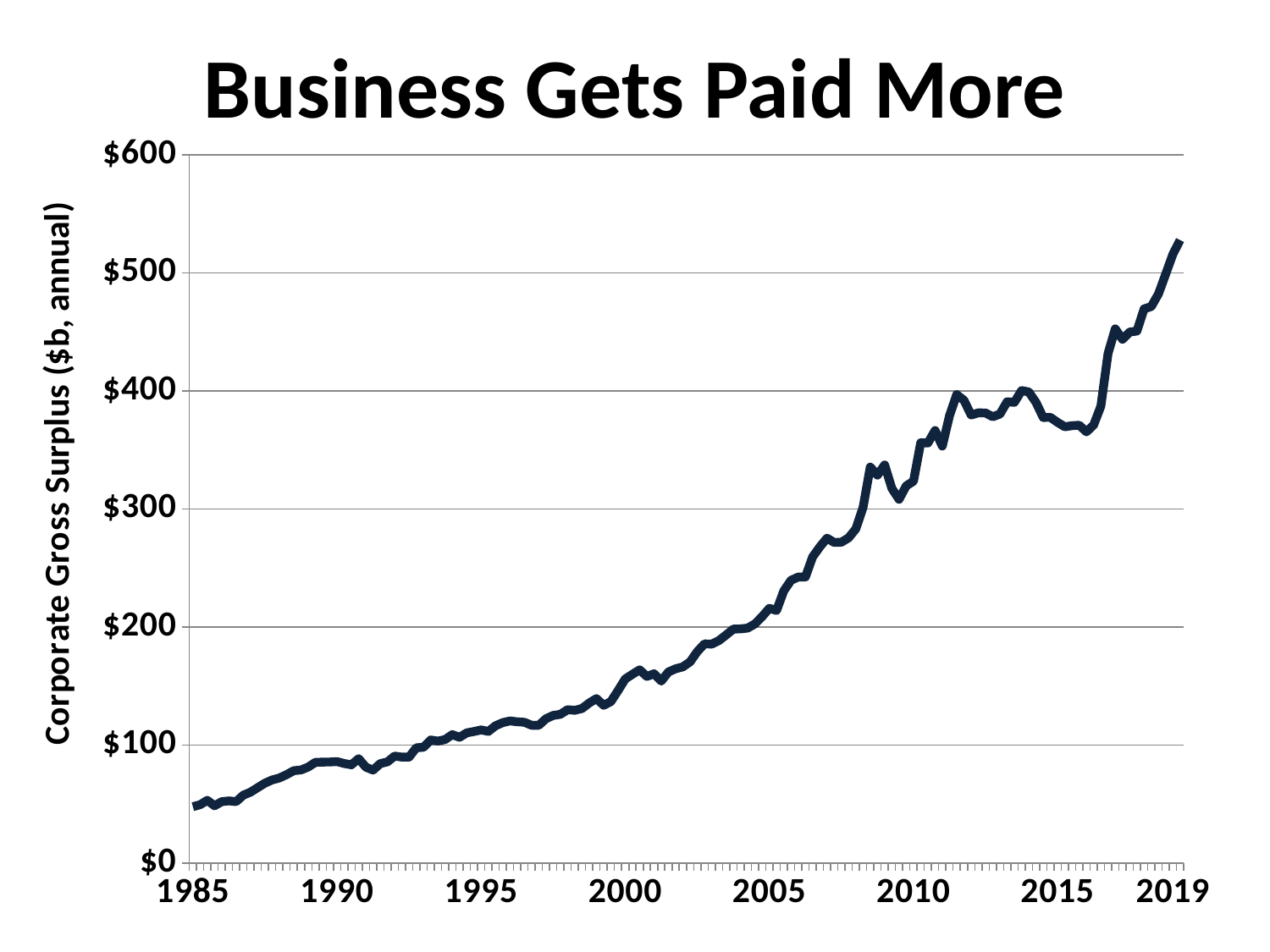
What is the title of the chart? Business Gets Paid More In which year shown on the x axis is the corporate gross surplus lowest? 1985 Is the value for 2000 greater or less than $100? greater Is the value for 1990 greater or less than $100? less Which year has the larger corporate gross surplus, 2000 or 2010? 2010 What is the label on the vertical axis? Corporate Gross Surplus ($b, annual) Is the value for 1985 greater or less than $100? less In which year shown on the x axis is the corporate gross surplus highest? 2019 Do the values generally rise or fall from 1985 to 2019? rise What kind of chart is shown on the slide? line chart